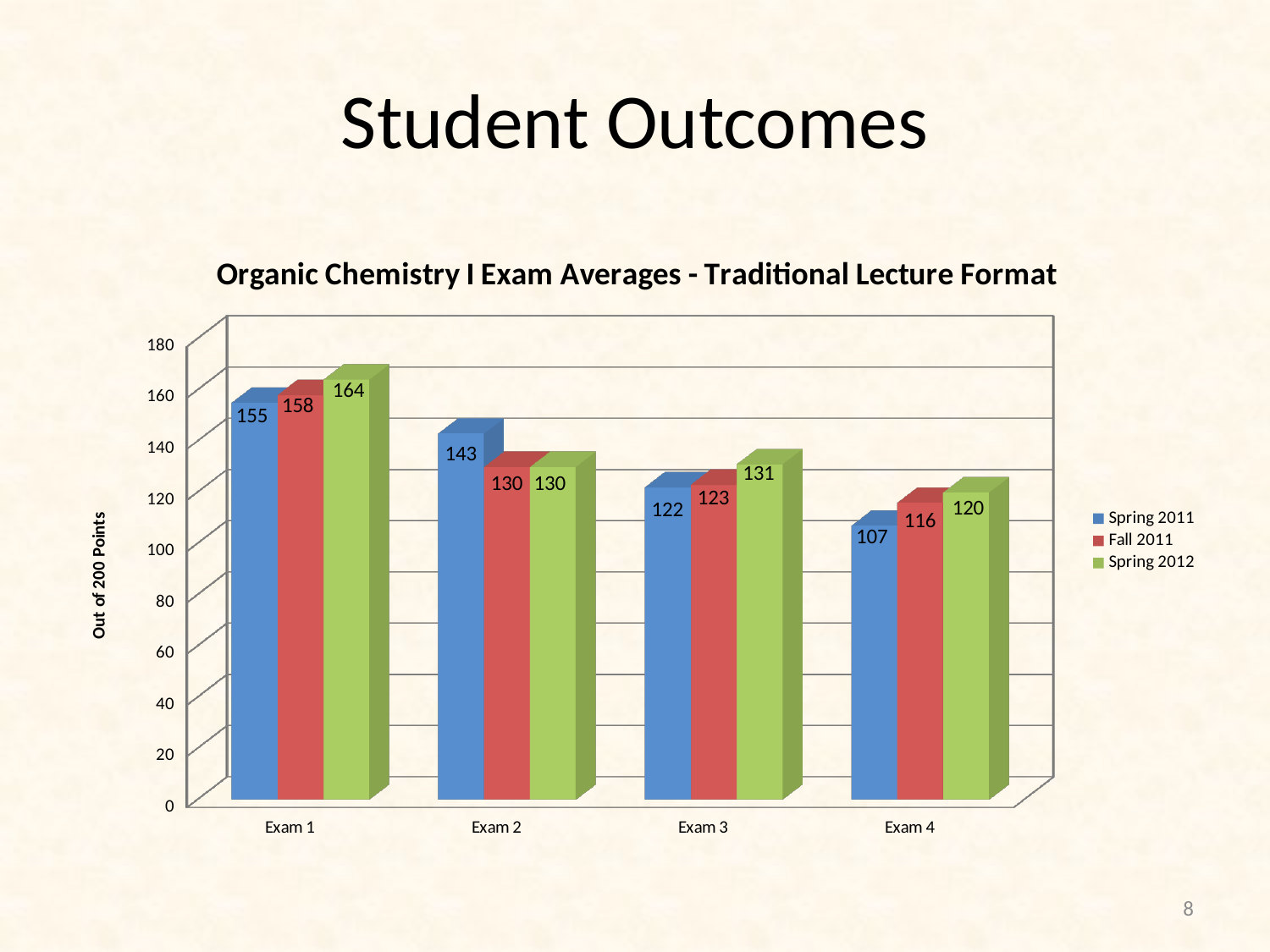
What is the difference between the Spring 2012 and Spring 2011 averages for Exam 1? 9 Which exam has the lowest Spring 2011 average? Exam 4 What is the Fall 2011 exam average for Exam 4? 116 What is the Spring 2011 exam average for Exam 2? 143 Do the Spring 2011 averages rise or fall from Exam 1 to Exam 4? Fall What is the title of the chart? Organic Chemistry I Exam Averages - Traditional Lecture Format How many exams are shown on the x axis? 4 Which is larger for Exam 2: the Spring 2011 average or the Fall 2011 average? Spring 2011 What kind of chart is shown on the slide? Bar chart How many series does the legend list? 3 Which exam has the highest Spring 2012 average? Exam 1 What is the Spring 2012 exam average for Exam 3? 131